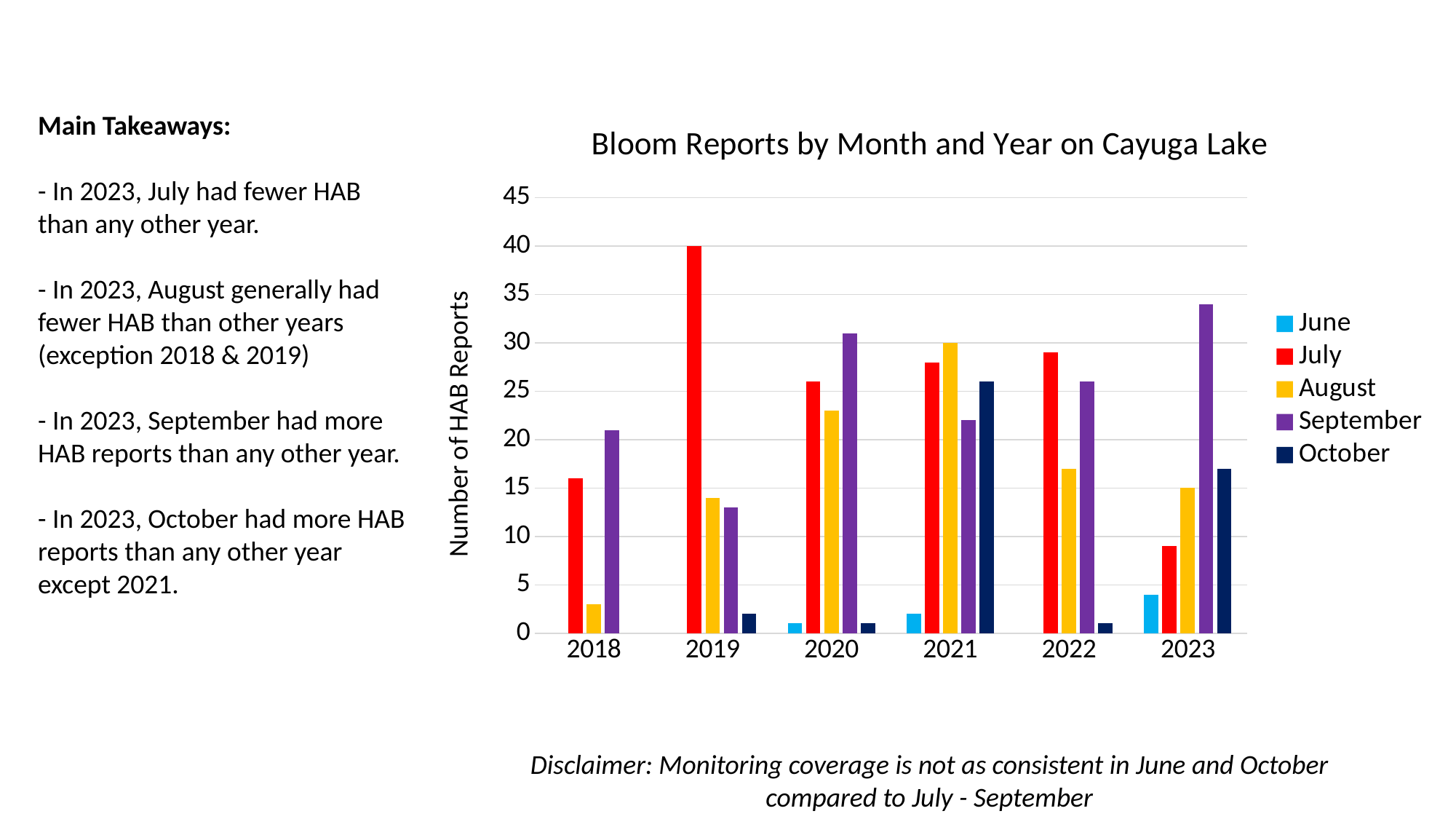
How many years are shown on the x axis? 6 Is the value for October in 2023 greater or less than 20? less Is the value for September in 2023 greater or less than 30? greater Which year has the lowest July value? 2023 What type of chart is shown on the slide? bar chart How many series does the legend list? 5 What is the number of HAB reports for July in 2019? 40 What is the number of HAB reports for August in 2023? 15 What is the number of HAB reports for August in 2021? 30 In 2019, which is larger, the July value or the September value? July Which year has the highest September value? 2023 Which year has the highest July value? 2019